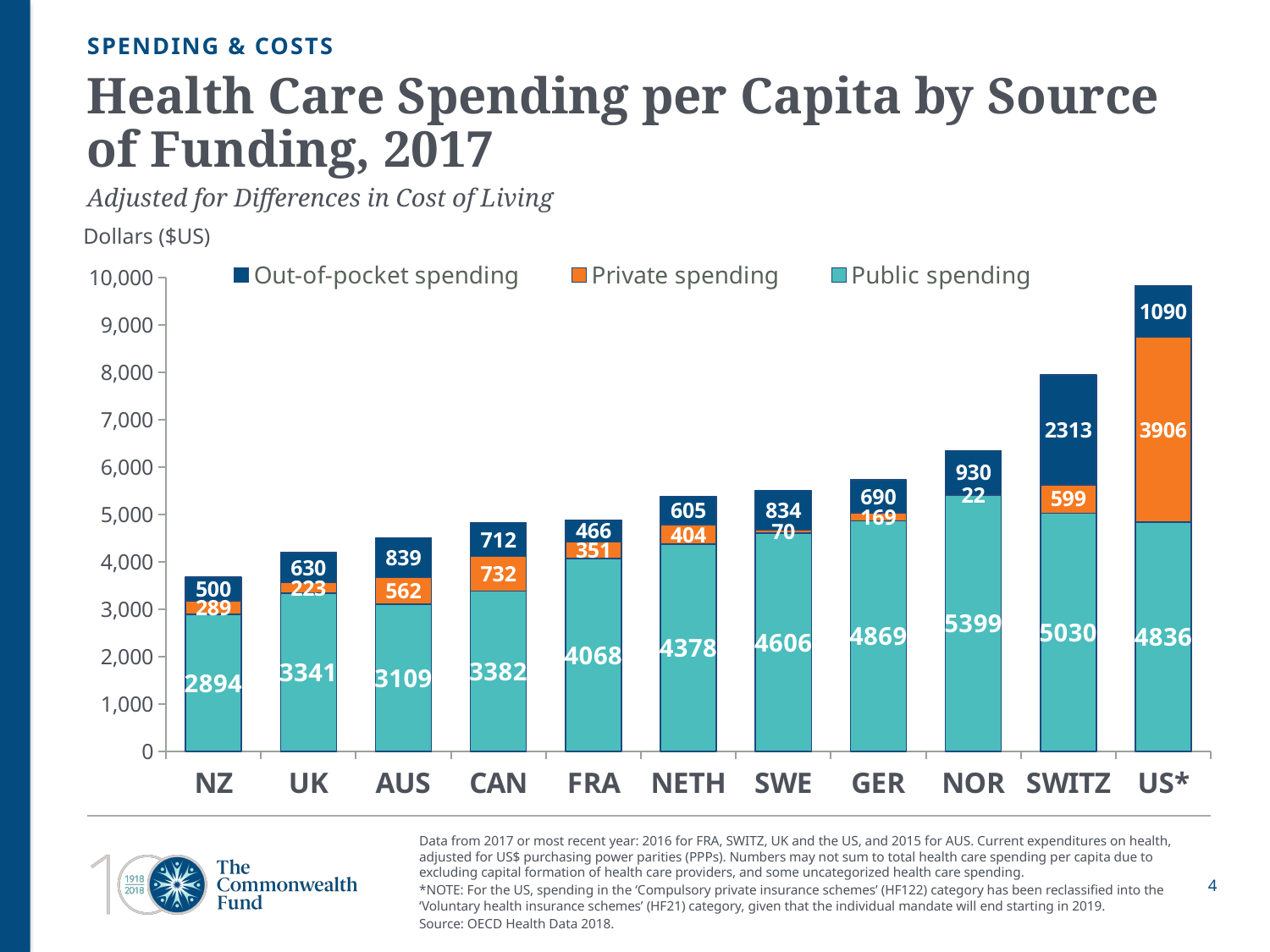
What is the out-of-pocket spending per capita for SWITZ? 2313 How much larger is out-of-pocket spending in SWITZ than in US*? 1223 How many countries are shown on the x axis? 11 Which has higher out-of-pocket spending, CAN or FRA? CAN What is the public spending per capita for NOR? 5399 What is the private spending per capita for US*? 3906 What is the total health care spending per capita for NZ (sum of the three segments)? 3683 How many series does the legend list? 3 Is the total bar height for US* greater or less than 9,000? greater Which country has the lowest private spending per capita? NOR Which country has the highest public spending per capita? NOR What kind of chart is shown on the slide? Stacked bar chart